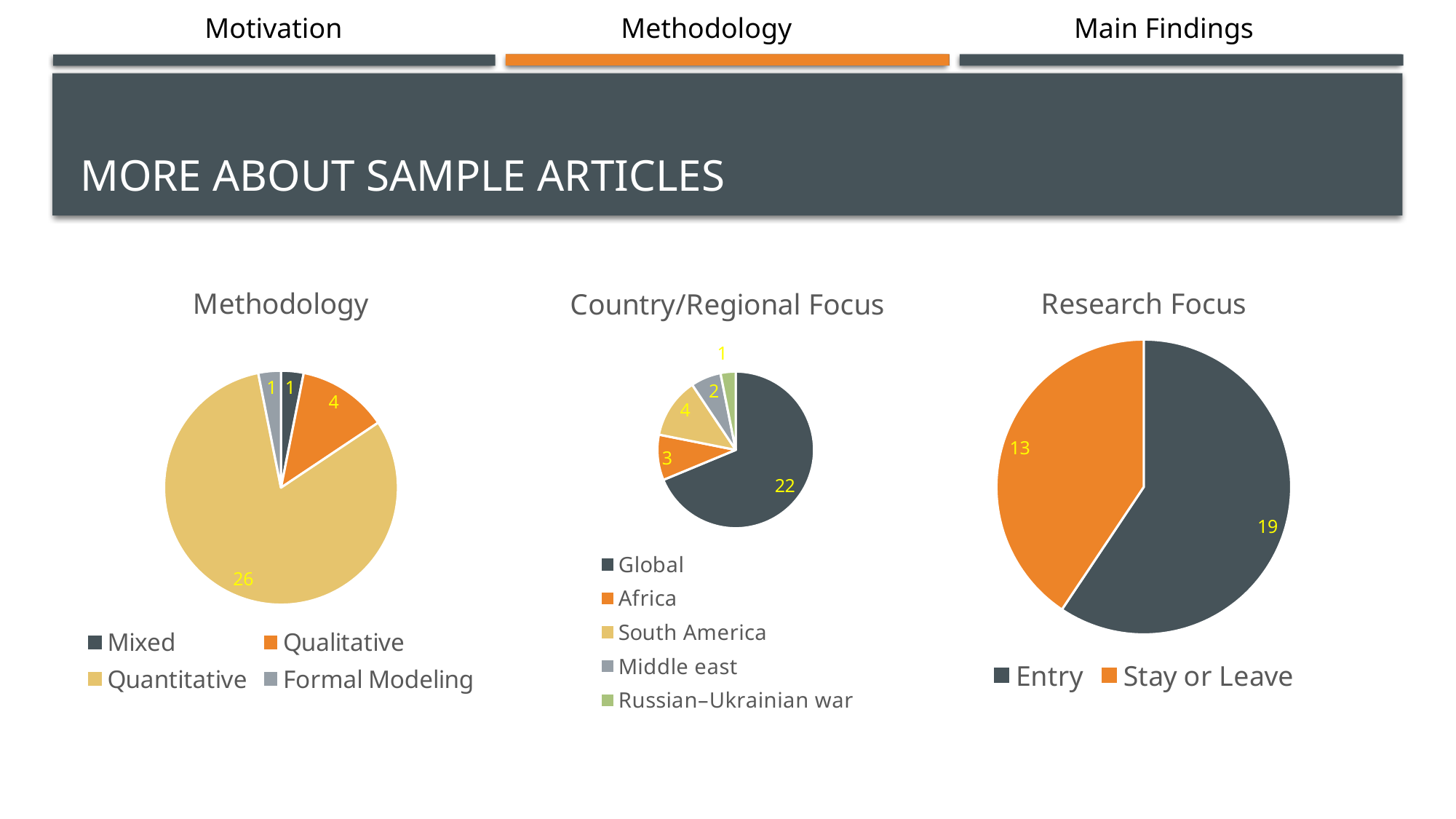
In the Methodology chart, what is the value for Quantitative? 26 In the Country/Regional Focus chart, what is the value for Global? 22 In the Research Focus chart, what is the difference between Entry and Stay or Leave? 6 In the Country/Regional Focus chart, what is the value for South America? 4 How many entries does the legend of the Methodology chart list? 4 In the Methodology chart, what is the value for Qualitative? 4 In the Research Focus chart, what is the value for Stay or Leave? 13 How many categories does the Country/Regional Focus chart show? 5 What kind of chart is the Research Focus chart? Pie chart In the Methodology chart, which category has the largest slice? Quantitative In the Country/Regional Focus chart, which category has the smallest slice? Russian–Ukrainian war In the Country/Regional Focus chart, which is larger, Africa or Middle east? Africa